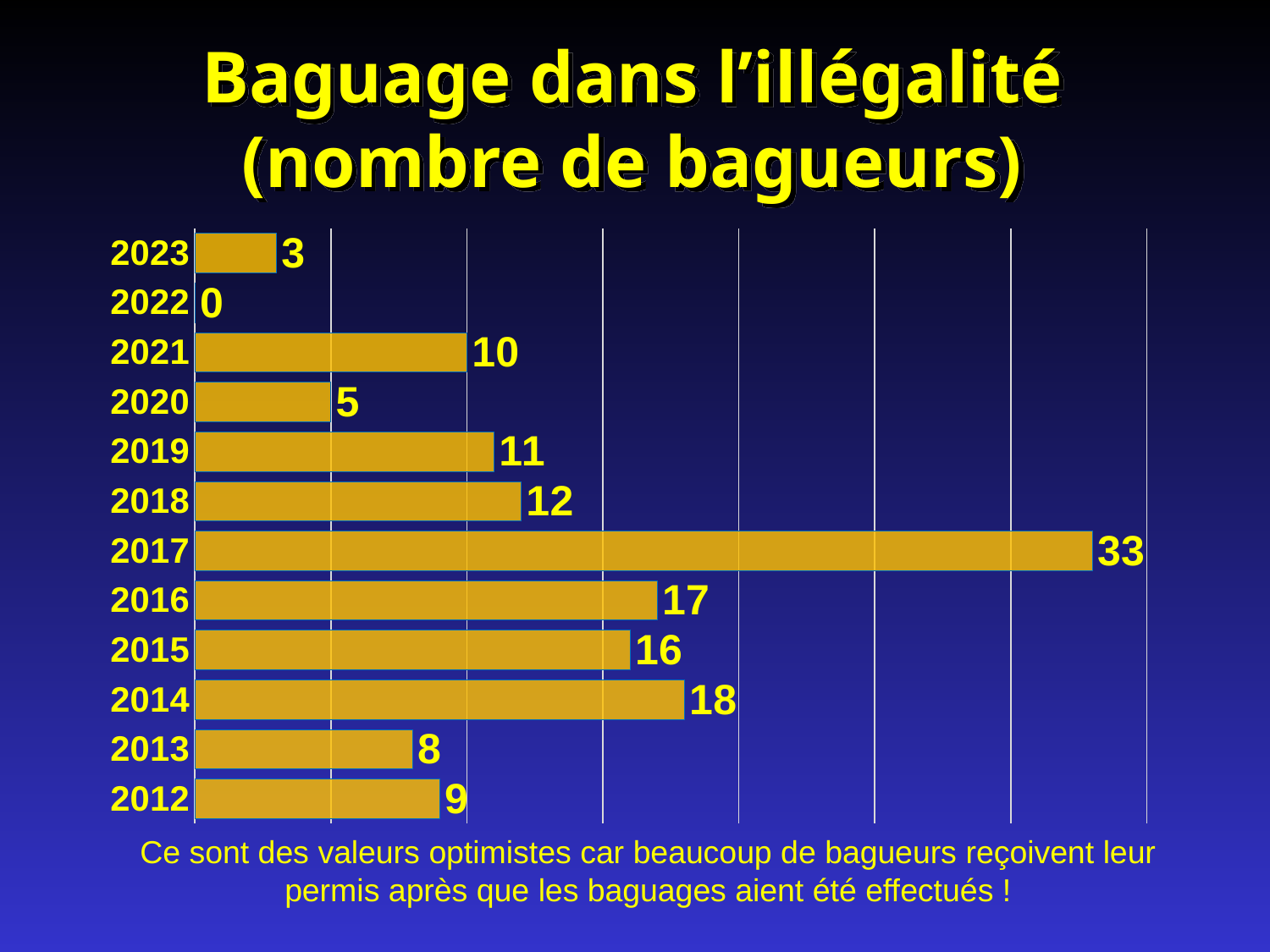
What is the number of bagueurs for 2012? 9 Which year has a larger value, 2015 or 2018? 2015 How many years are shown on the chart? 12 What is the number of bagueurs for 2021? 10 Which year has the lowest number of bagueurs? 2022 Which year has a larger value, 2019 or 2020? 2019 What is the number of bagueurs for 2017? 33 Which year has the highest number of bagueurs? 2017 What kind of chart is shown on the slide? Bar chart What is the difference between the values for 2014 and 2013? 10 What is the difference between the values for 2017 and 2016? 16 What is the title of the chart? Baguage dans l'illégalité (nombre de bagueurs)